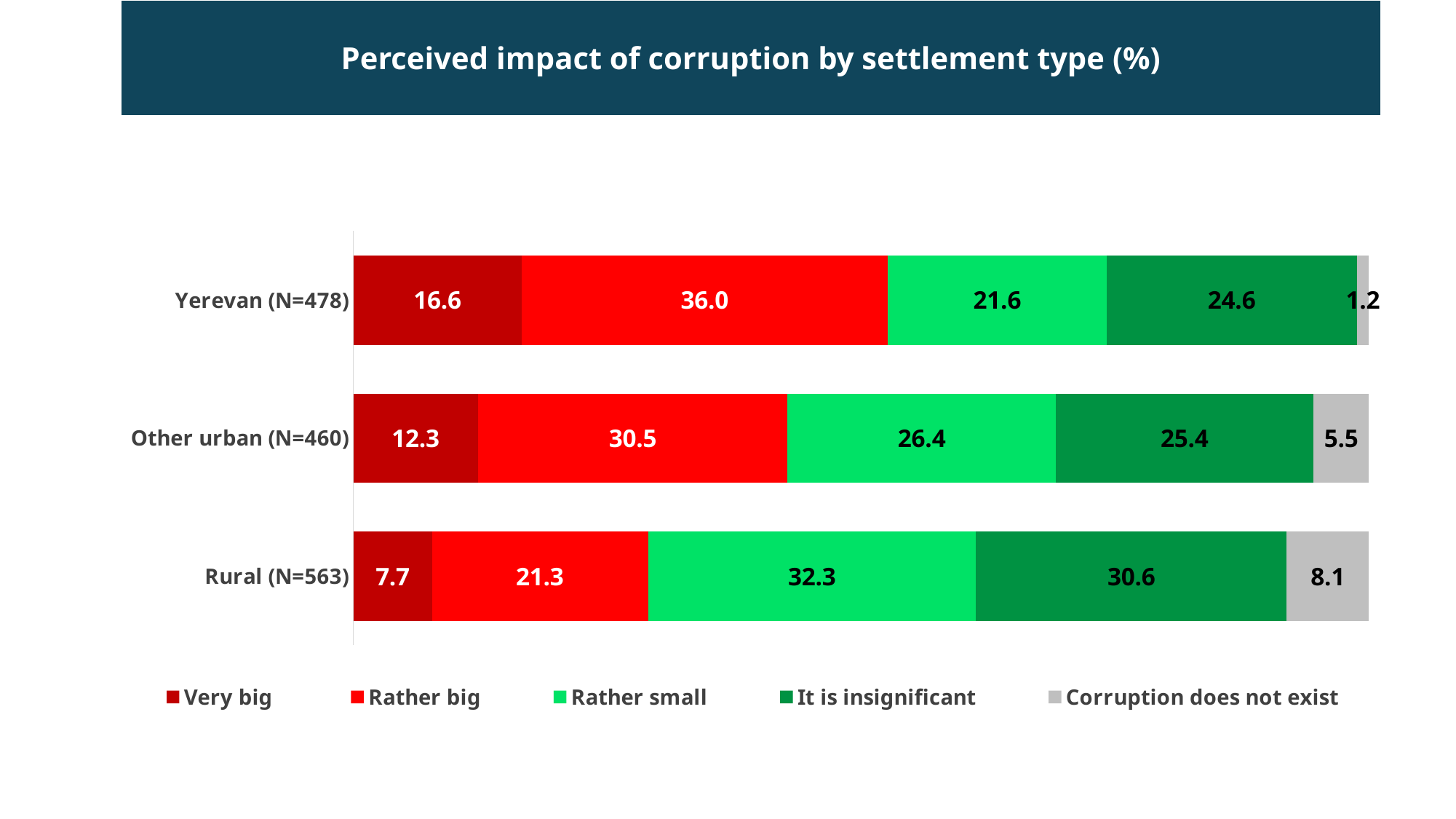
What is the total of the stacked bar for Rural (N=563)? 100.0 Which is larger: the 'It is insignificant' value for Rural (N=563) or for Other urban (N=460)? Rural (N=563) What kind of chart is shown on the slide? Stacked bar chart What is the difference between the 'Rather big' values for Yerevan (N=478) and Rural (N=563)? 14.7 Which settlement type has the highest 'Rather big' value? Yerevan (N=478) What is the 'Rather small' value for Rural (N=563)? 32.3 Which settlement type has the lowest 'Very big' value? Rural (N=563) What is the title of the chart? Perceived impact of corruption by settlement type (%) How many settlement types are shown in the chart? 3 What is the 'Corruption does not exist' value for Other urban (N=460)? 5.5 What is the 'Very big' value for Yerevan (N=478)? 16.6 How many series does the legend list? 5